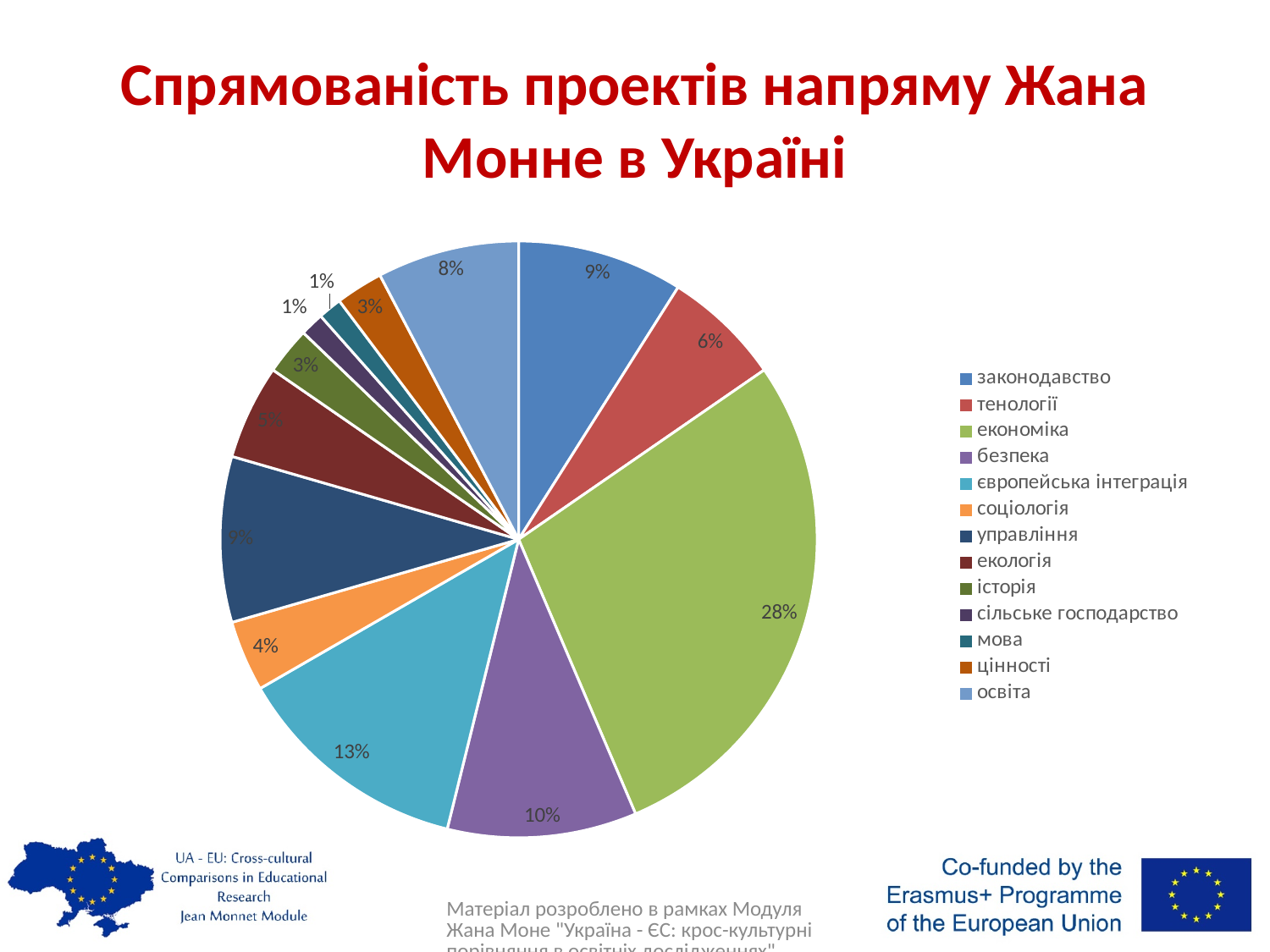
What share of the pie does соціологія have? 4% What is the difference between the share for економіка and the share for європейська інтеграція? 15% What is the title of the slide containing the chart? Спрямованість проектів напряму Жана Монне в Україні What kind of chart is shown on the slide? pie chart What share of the pie does економіка have? 28% How many categories does the legend list? 13 What share of the pie does безпека have? 10% Which is larger, the slice for європейська інтеграція or the slice for безпека? європейська інтеграція Which category has the largest slice of the pie? економіка